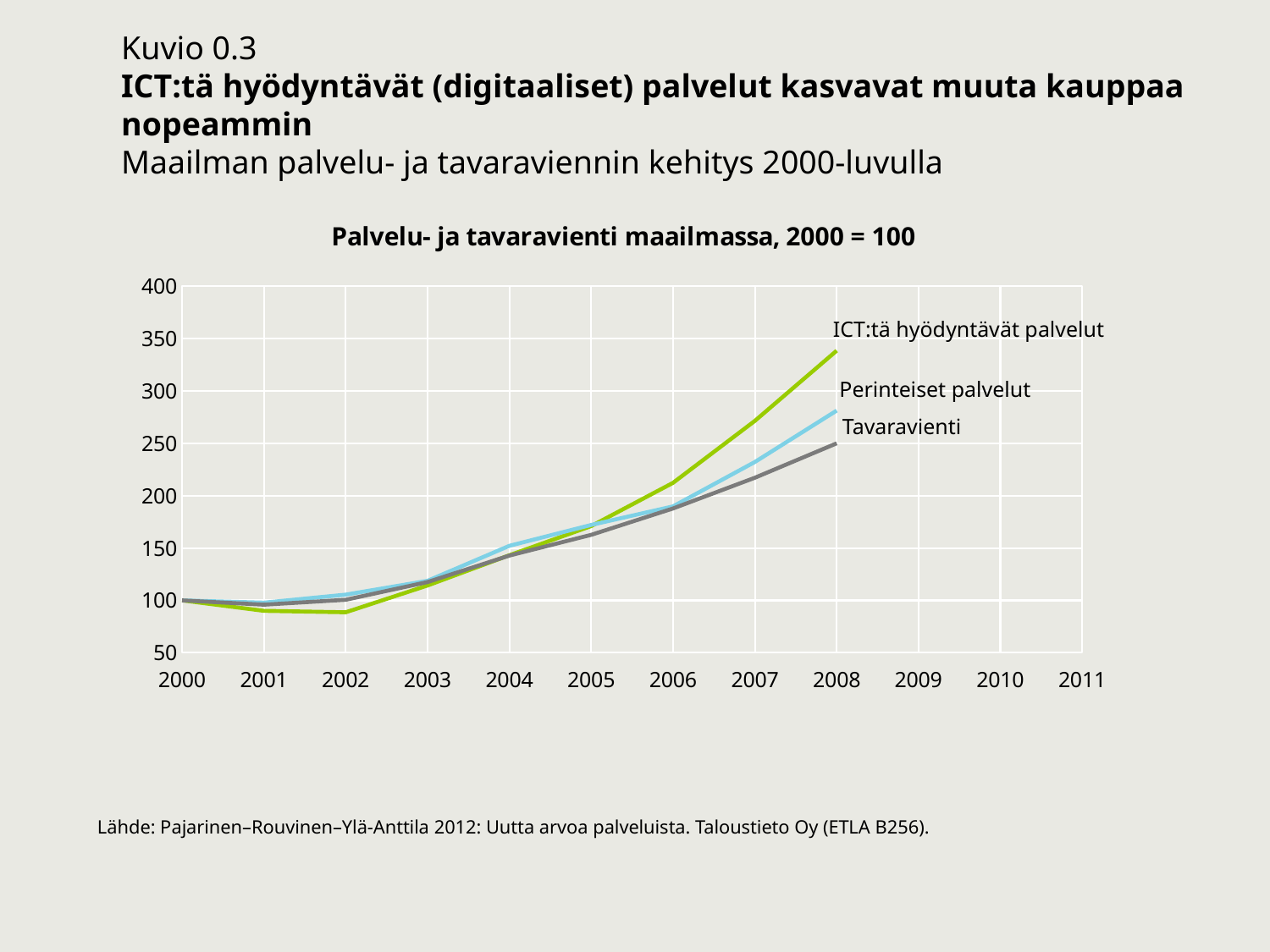
What kind of chart is shown on the slide? line chart How many years are labelled on the x axis? 12 Is the value for ICT:tä hyödyntävät palvelut in 2002 greater or less than 100? less Do the values for ICT:tä hyödyntävät palvelut rise or fall between 2003 and 2008? rise In 2002, which is larger: Tavaravienti or ICT:tä hyödyntävät palvelut? Tavaravienti What is the title of the chart? Palvelu- ja tavaravienti maailmassa, 2000 = 100 Which series has the highest value in 2008? ICT:tä hyödyntävät palvelut Is the value for Tavaravienti in 2008 greater or less than 200? greater Is the value for ICT:tä hyödyntävät palvelut in 2008 greater or less than 300? greater How many series are plotted in the chart? 3 Which series has the lowest value in 2008? Tavaravienti